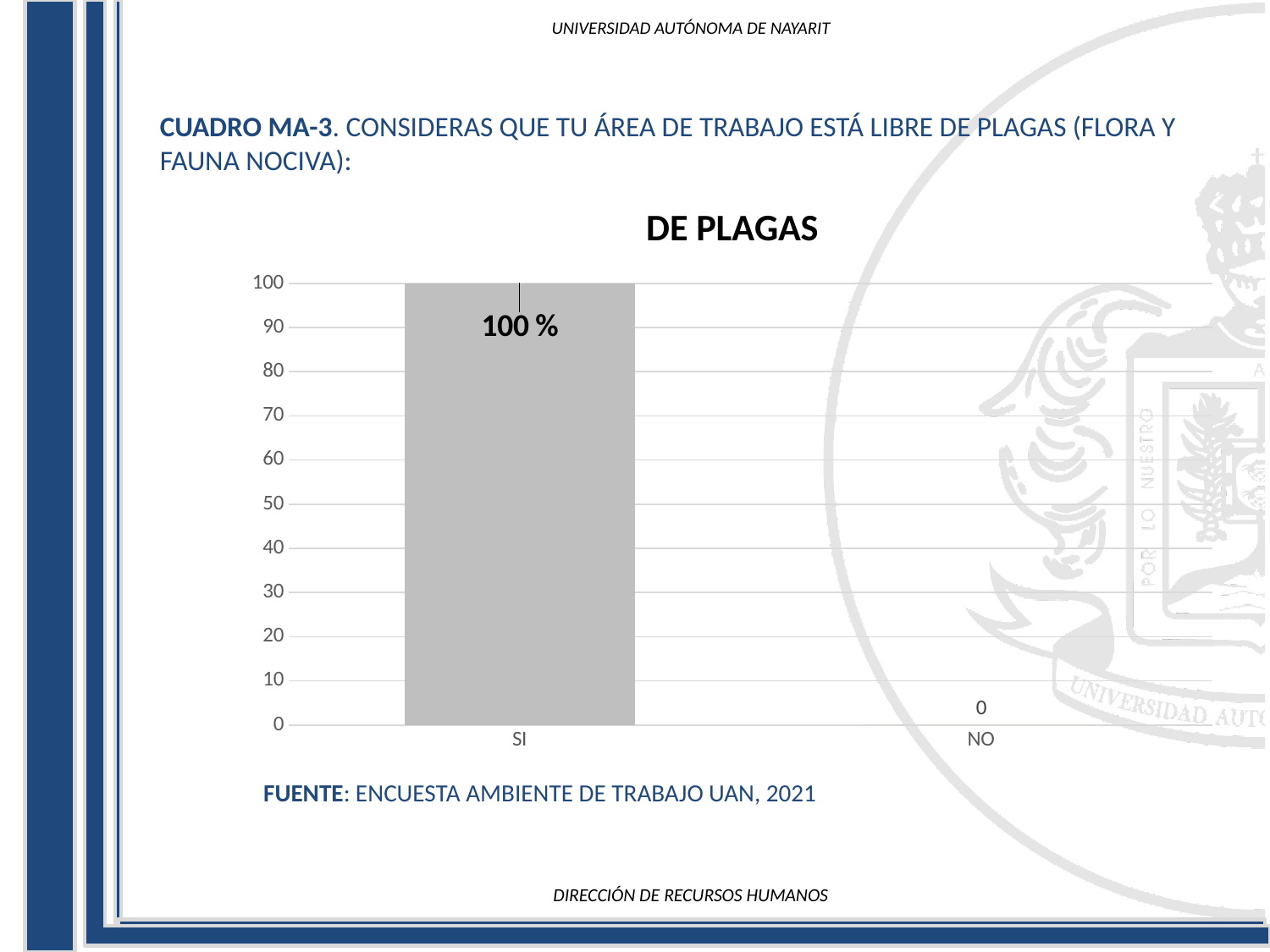
Do the values rise or fall from SI to NO? fall What is the highest value shown on the y axis? 100 What is the value for NO? 0 What is the title of the chart? DE PLAGAS How many categories are shown on the x axis? 2 What is the value for SI? 100 % Which category has the highest value? SI What kind of chart is shown on the slide? bar chart Which is larger, the value for SI or the value for NO? SI Is the value for SI greater or less than 50? greater Which category has the lowest value? NO